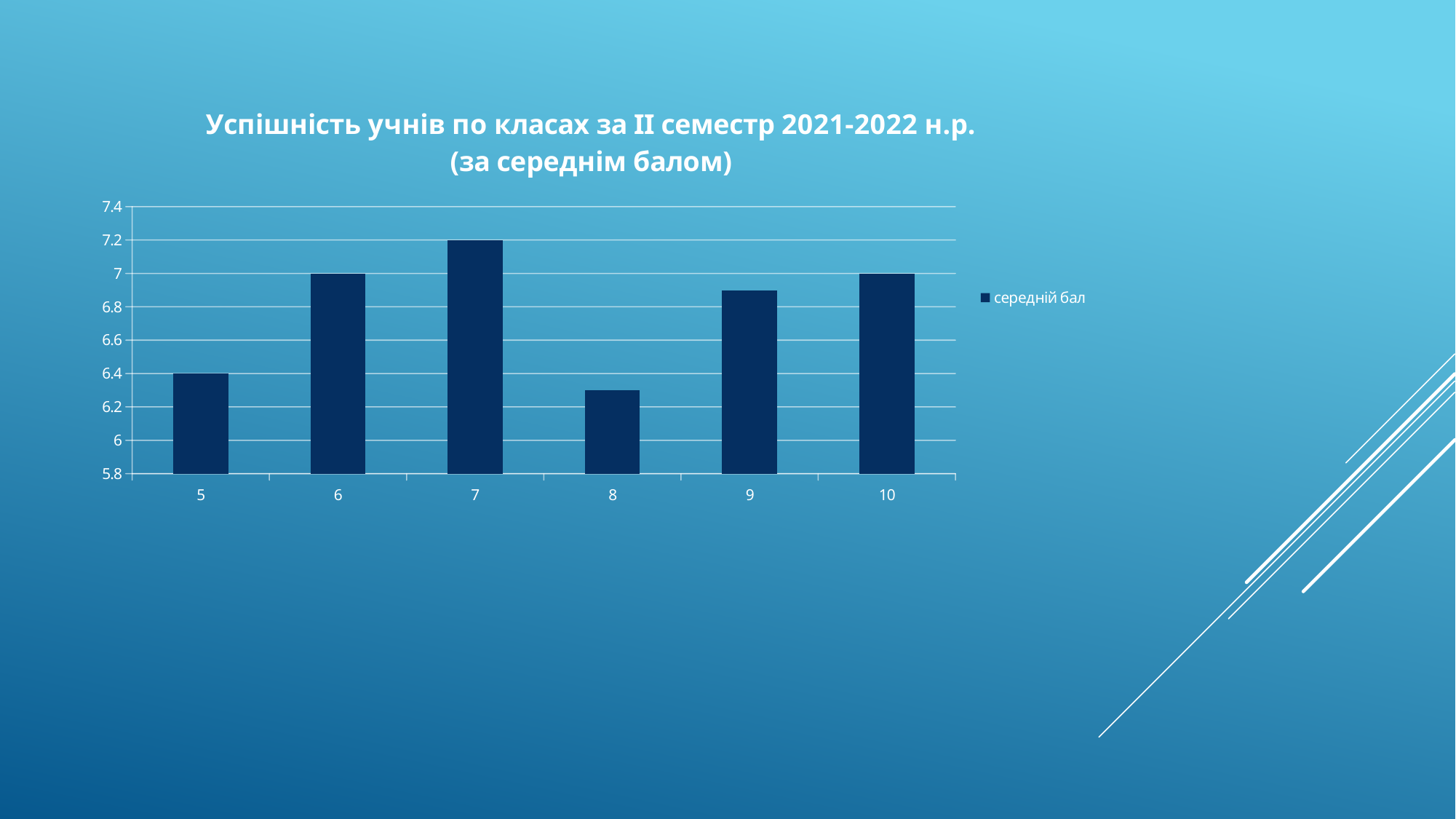
What is the average score for class 7? 7.2 What is the difference between the average scores of class 7 and class 5? 0.8 Which class has the larger average score, class 7 or class 6? 7 How many classes are shown on the x axis? 6 Which class has the highest average score? 7 What is the average score for class 10? 7 Is the value for class 9 greater or less than 7? less How many series does the legend list? 1 Which class has the lowest average score? 8 What kind of chart is shown on the slide? bar chart Is the value for class 8 greater or less than 6.4? less What is the average score (середній бал) for class 5? 6.4